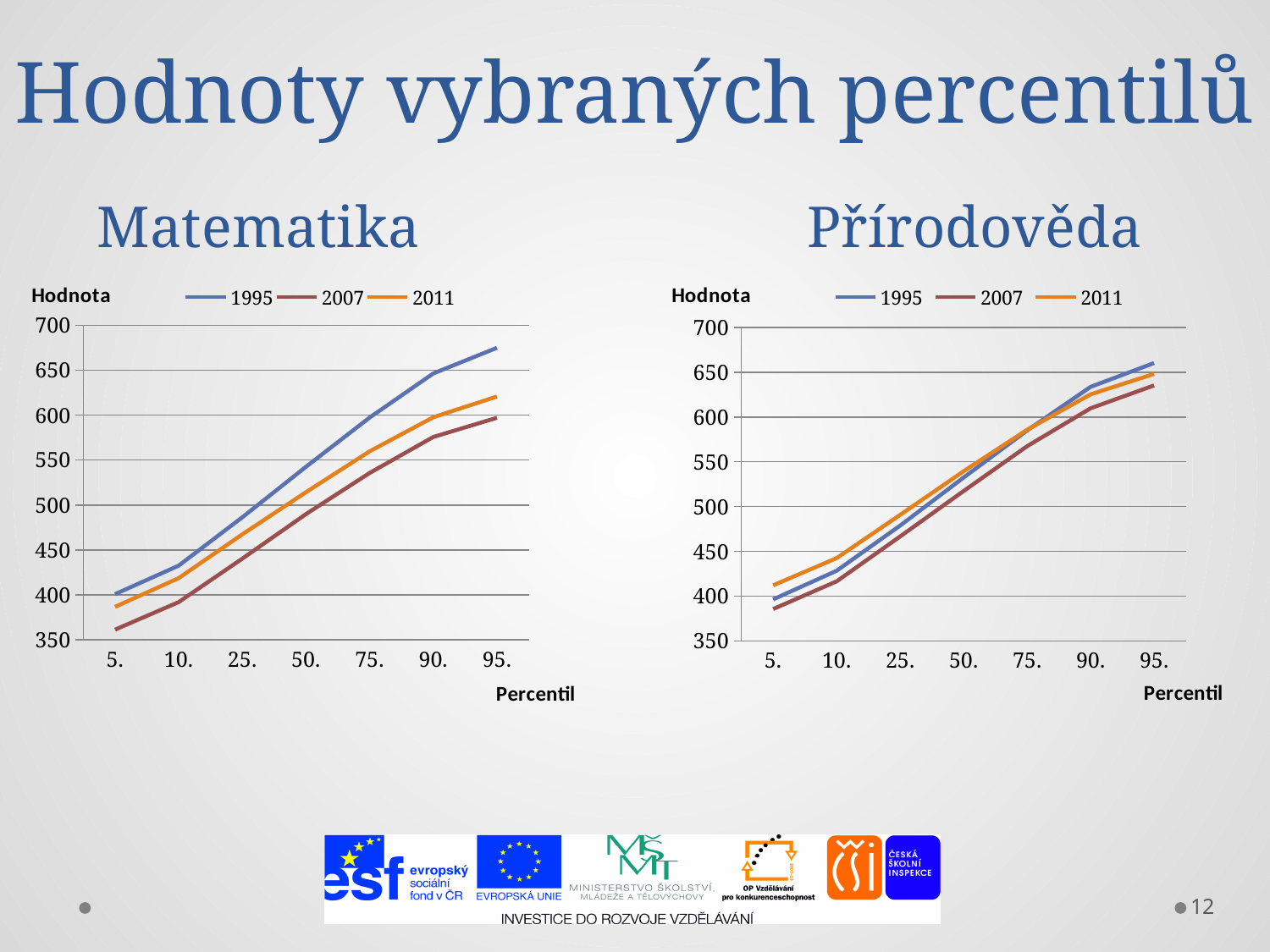
In the Matematika chart, do the values rise or fall as the percentile increases along the x axis? rise In the Matematika chart, which series has the lowest value at the 5th percentile? 2007 In the Přírodověda chart, is the value for 2011 at the 5th percentile greater or less than 400? greater How many series does the legend of the Přírodověda chart list? 3 How many percentile categories are shown on the x axis of the Matematika chart? 7 In the Matematika chart, is the value for 1995 at the 95th percentile greater or less than 650? greater What is the label of the y axis on the Přírodověda chart? Hodnota In the Přírodověda chart, which is larger at the 95th percentile: the value for 1995 or the value for 2007? 1995 In the Přírodověda chart, which series has the lowest value at the 5th percentile? 2007 What type of chart is the Matematika chart? line chart In the Matematika chart, is the value for 2007 at the 5th percentile greater or less than 400? less In the Matematika chart, which series has the highest value at the 95th percentile? 1995